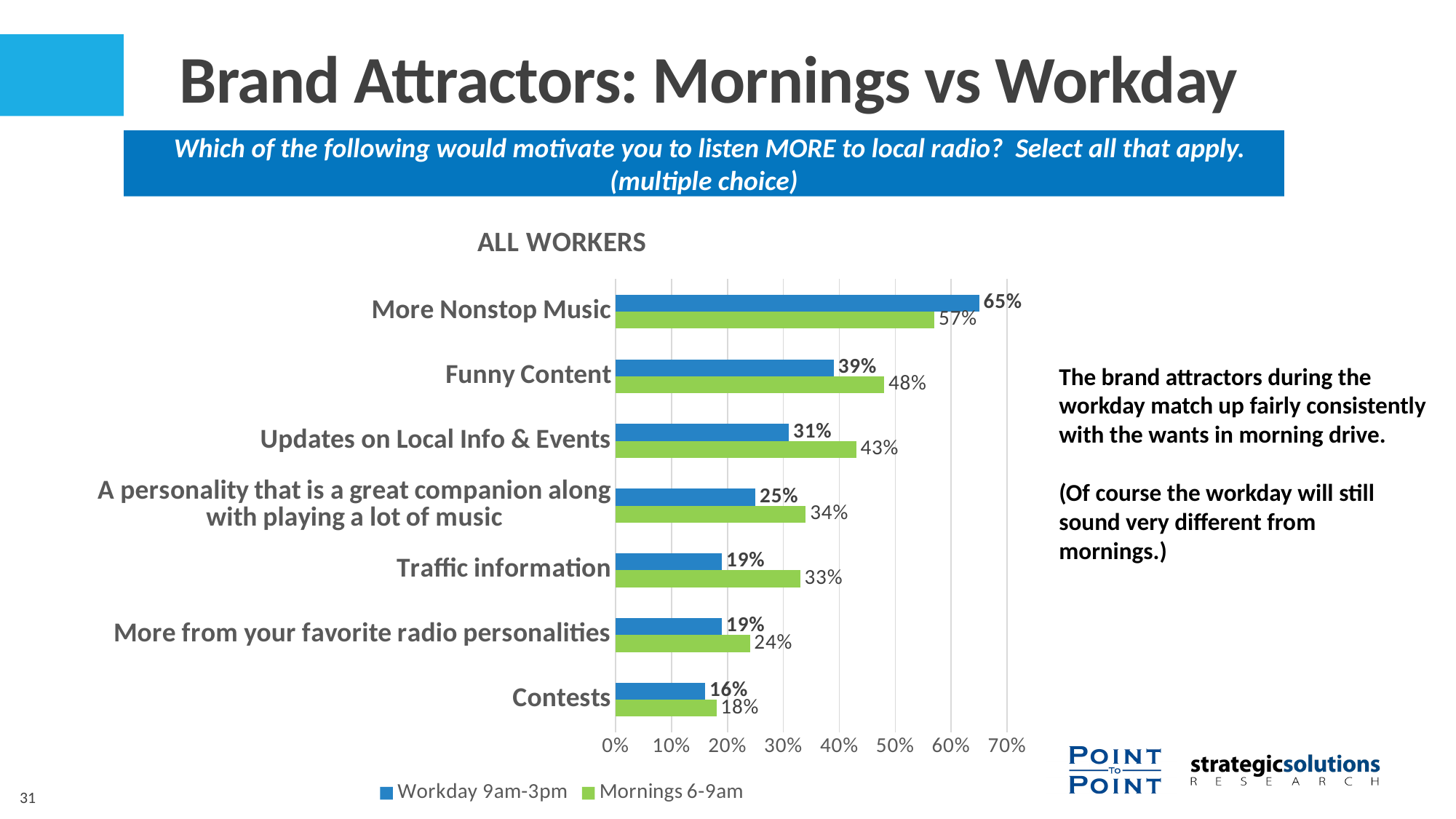
For Funny Content, which is larger: the Workday 9am-3pm value or the Mornings 6-9am value? Mornings 6-9am What kind of chart is shown on the slide? Bar chart What is the Mornings 6-9am value for Funny Content? 48% What is the Mornings 6-9am value for Traffic information? 33% What is the Workday 9am-3pm value for More Nonstop Music? 65% Which category has the highest Workday 9am-3pm value? More Nonstop Music What is the difference between the Mornings 6-9am and Workday 9am-3pm values for Updates on Local Info & Events? 12% What is the Workday 9am-3pm value for Contests? 16% How many series does the legend list? 2 How many categories are shown in the chart? 7 Which category has the lowest Mornings 6-9am value? Contests Which colour represents the Mornings 6-9am series? Green